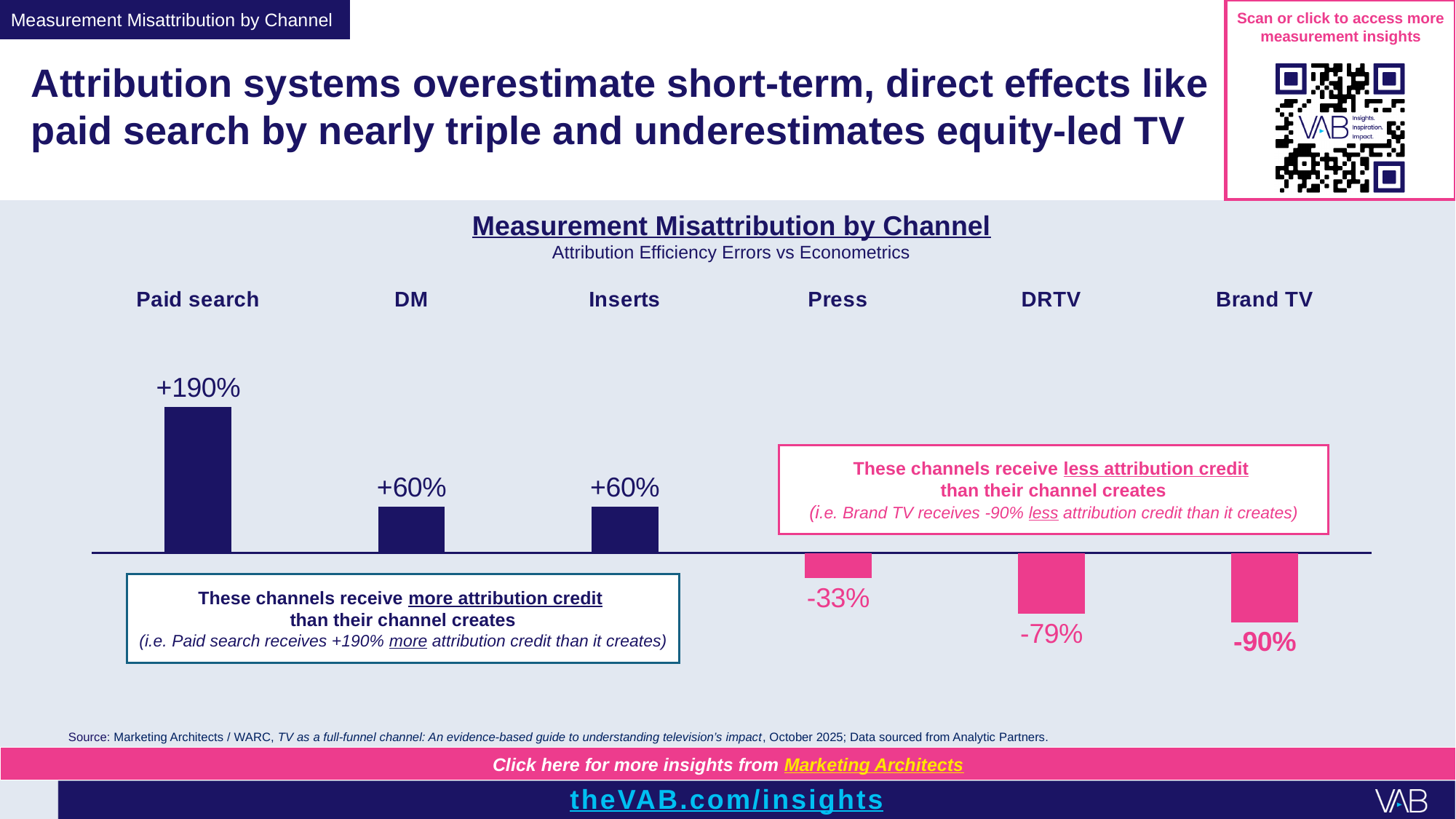
What is the value for Brand TV? -90% How many channels are shown in the chart? 6 What is the subtitle of the chart? Attribution Efficiency Errors vs Econometrics What is the value for Paid search? +190% Which channel has the lowest value? Brand TV Do the values rise or fall moving from Paid search to Brand TV along the x axis? Fall Which channel has the highest value? Paid search What is the value for DRTV? -79% What is the difference between the values for Paid search and DM? 130 percentage points Which is larger, the value for DRTV or the value for Press? Press What kind of chart is shown on the slide? Bar chart What is the value for Press? -33%